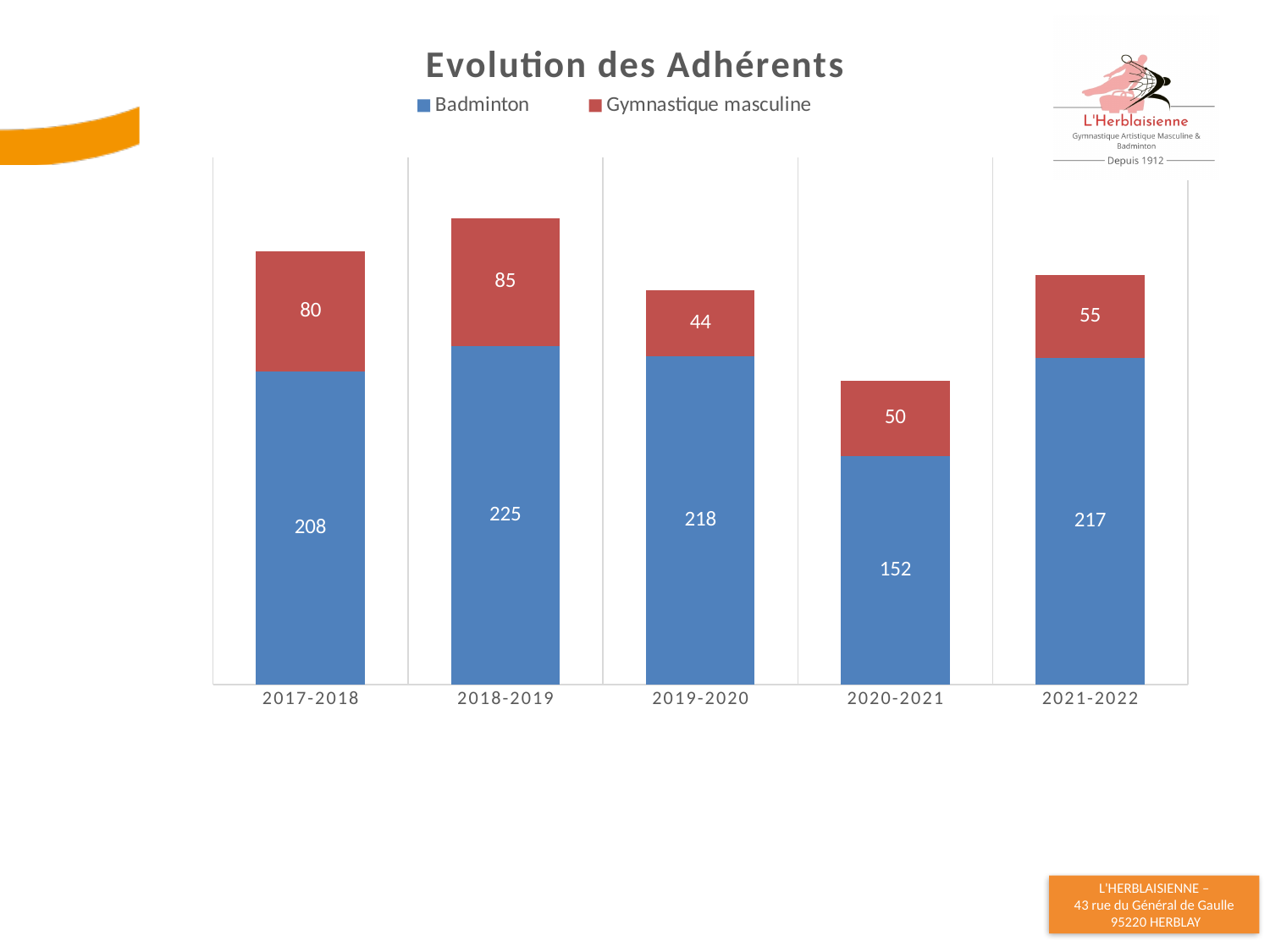
What kind of chart is shown on the slide? Stacked bar chart How many seasons are shown on the x axis? 5 What is the Badminton value for 2020-2021? 152 Which season has the lowest Gymnastique masculine value? 2019-2020 What is the Badminton value for 2018-2019? 225 What is the total of the stacked bar for 2017-2018? 288 What is the Gymnastique masculine value for 2019-2020? 44 Which is larger, the Gymnastique masculine value for 2017-2018 or for 2021-2022? 2017-2018 How many series does the legend list? 2 What is the total of the stacked bar for 2020-2021? 202 What is the difference between the Badminton values for 2018-2019 and 2020-2021? 73 Which season has the highest Badminton value? 2018-2019